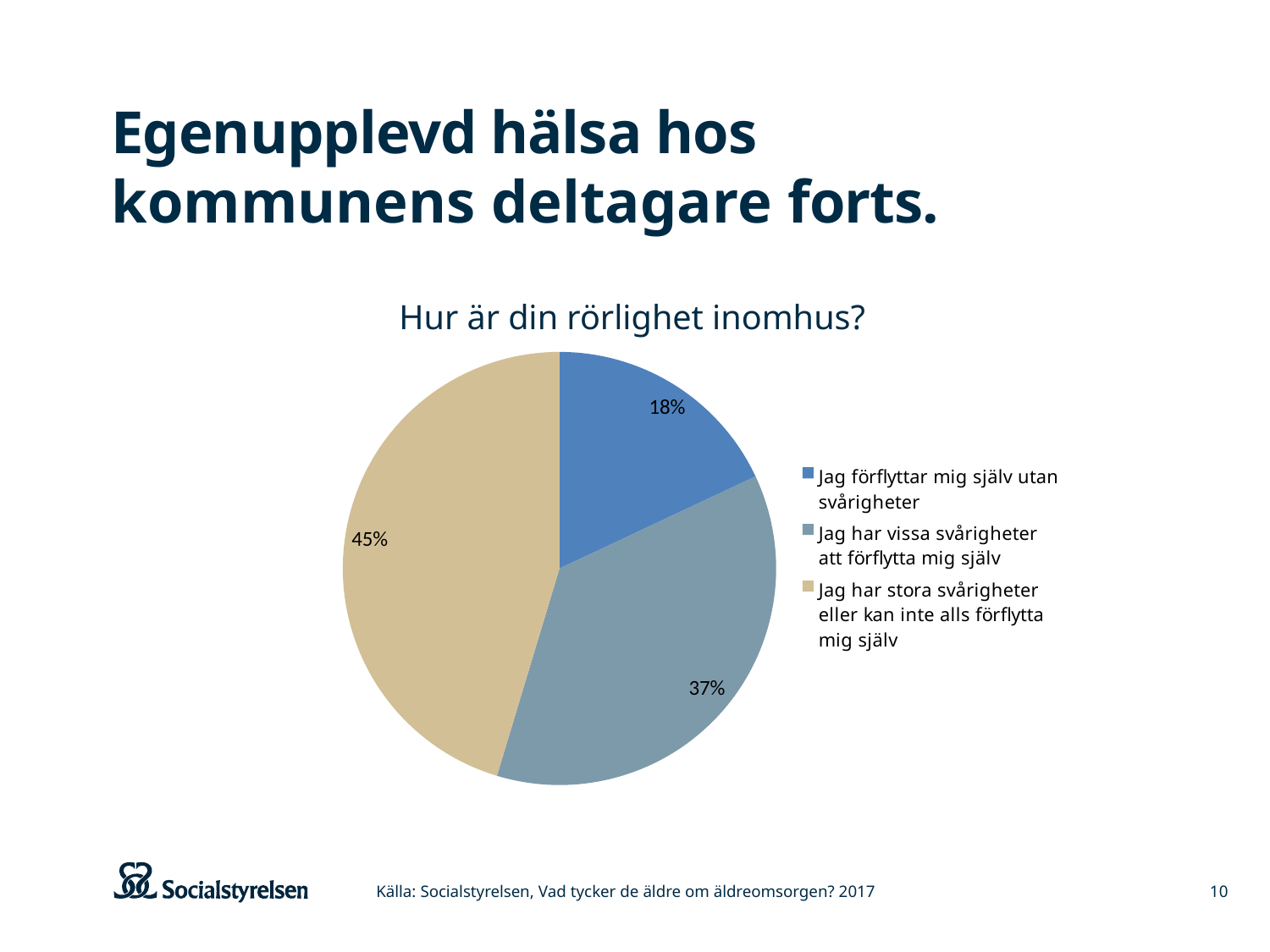
Which category has the largest slice of the pie? Jag har stora svårigheter eller kan inte alls förflytta mig själv What kind of chart is shown on the slide? pie chart What share of the pie is labelled for "Jag förflyttar mig själv utan svårigheter"? 18% Which is larger: the slice for "Jag har vissa svårigheter att förflytta mig själv" or the slice for "Jag förflyttar mig själv utan svårigheter"? Jag har vissa svårigheter att förflytta mig själv How many entries does the legend list? 3 What share of the pie is labelled for "Jag har vissa svårigheter att förflytta mig själv"? 37% Which category has the smallest slice of the pie? Jag förflyttar mig själv utan svårigheter What is the difference in percentage points between the 45% slice and the 18% slice? 27 percentage points What colour is the slice for "Jag har stora svårigheter eller kan inte alls förflytta mig själv"? beige (tan) What share of the pie is labelled for "Jag har stora svårigheter eller kan inte alls förflytta mig själv"? 45% How many slices does the pie chart have? 3 What is the chart's title? Hur är din rörlighet inomhus?